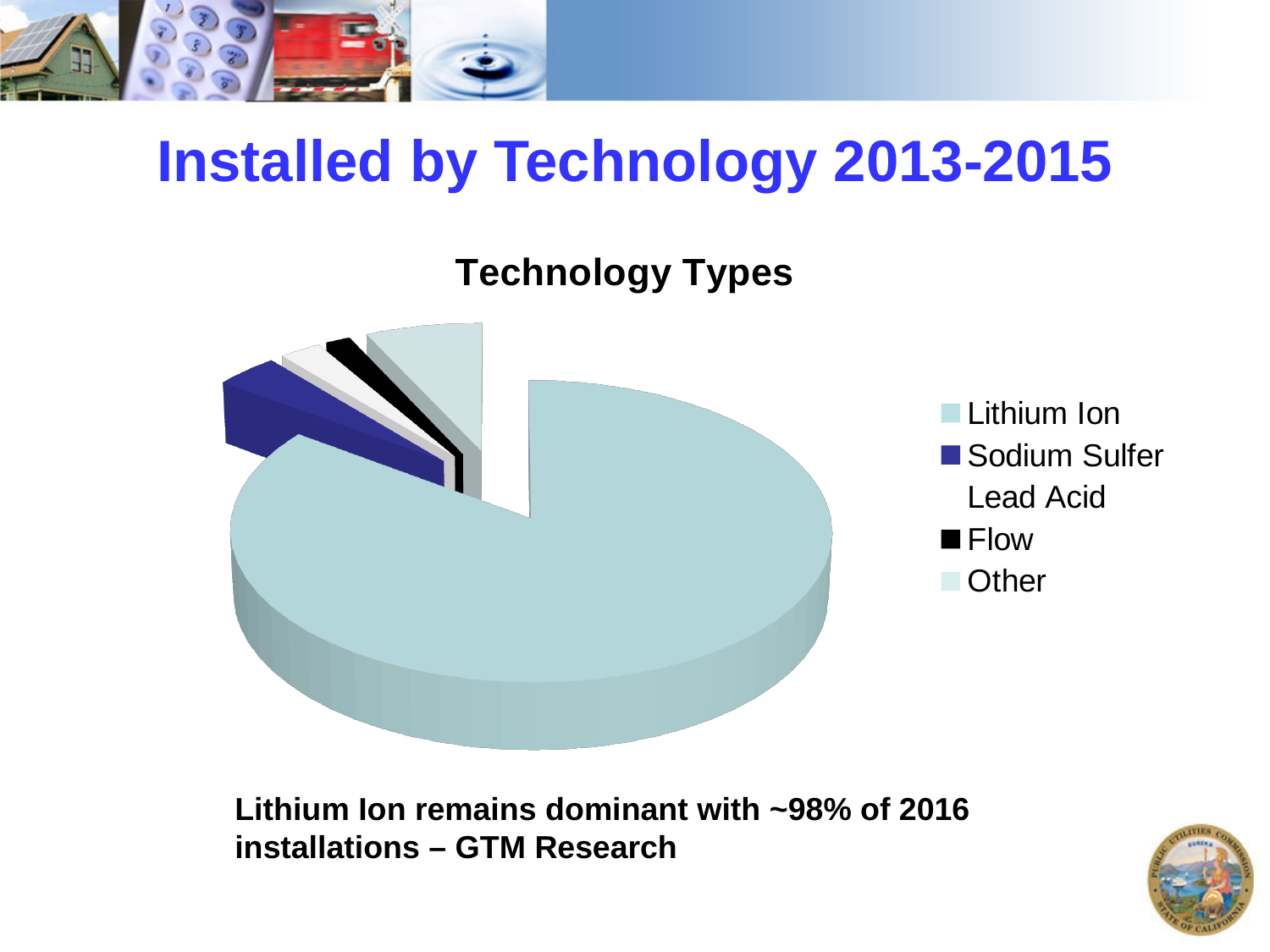
Which technology type has the largest slice of the pie? Lithium Ion Which is larger, the slice for Lithium Ion or the slice for Other? Lithium Ion Which is larger, the slice for Sodium Sulfer or the slice for Flow? Sodium Sulfer What is the title of the chart? Technology Types Which is larger, the slice for Other or the slice for Flow? Other How many entries does the chart legend list? 5 What kind of chart is shown on the slide? Pie chart How many technology categories does the pie chart show? 5 What colour is the Flow slice in the pie chart? Black